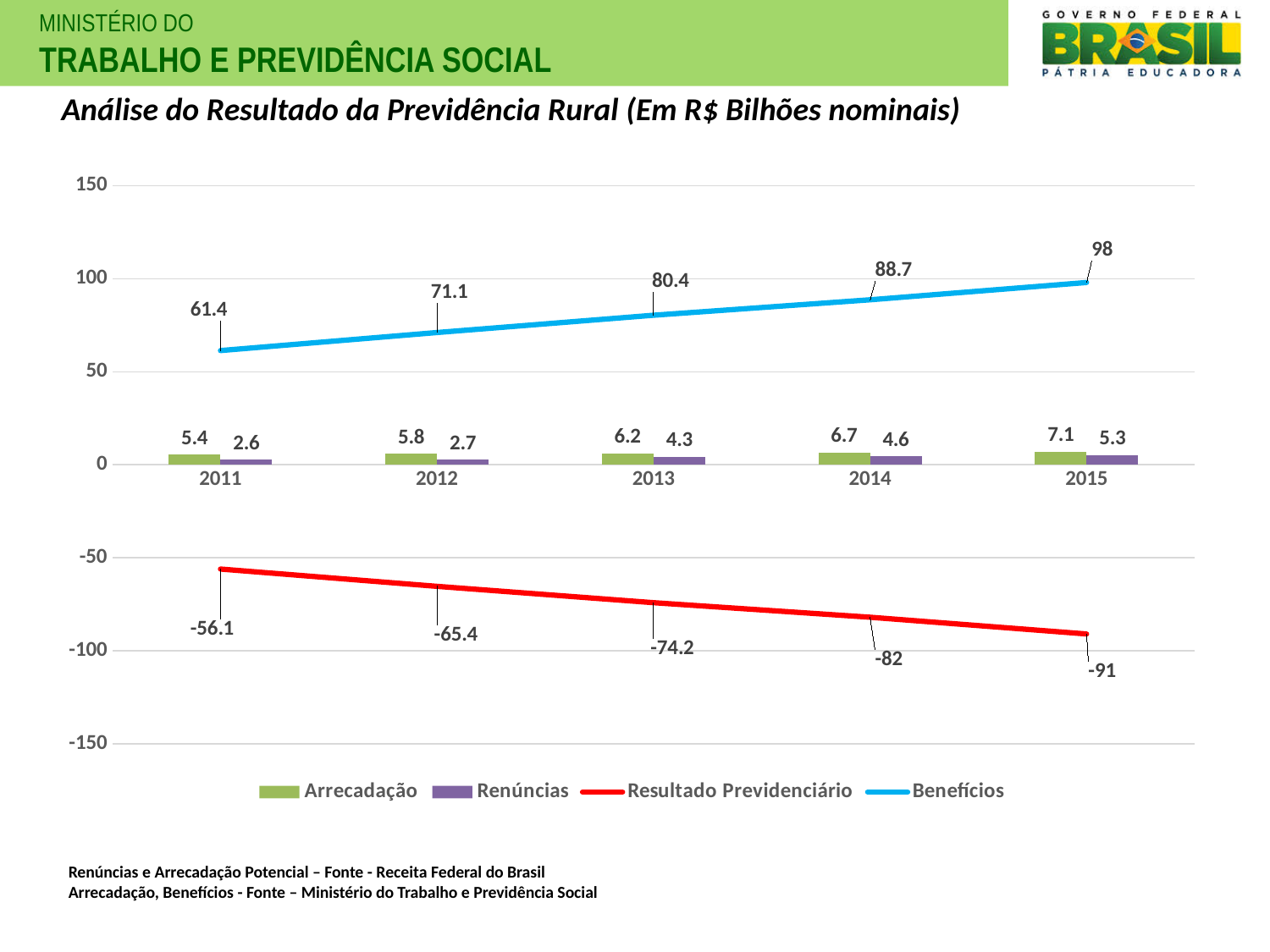
What is the value of Arrecadação in 2015? 7.1 Which is larger in 2013: Arrecadação or Renúncias? Arrecadação In which year is Arrecadação lowest? 2011 Does the Resultado Previdenciário line rise or fall from 2011 to 2015? fall What colour is the Benefícios line? blue What is the Resultado Previdenciário in 2014? -82 What is the difference between Benefícios in 2015 and in 2011? 36.6 In which year is Benefícios highest? 2015 How many series does the legend list? 4 How many years are shown on the x axis? 5 What is the value of Renúncias in 2011? 2.6 What is the value of Benefícios in 2013? 80.4